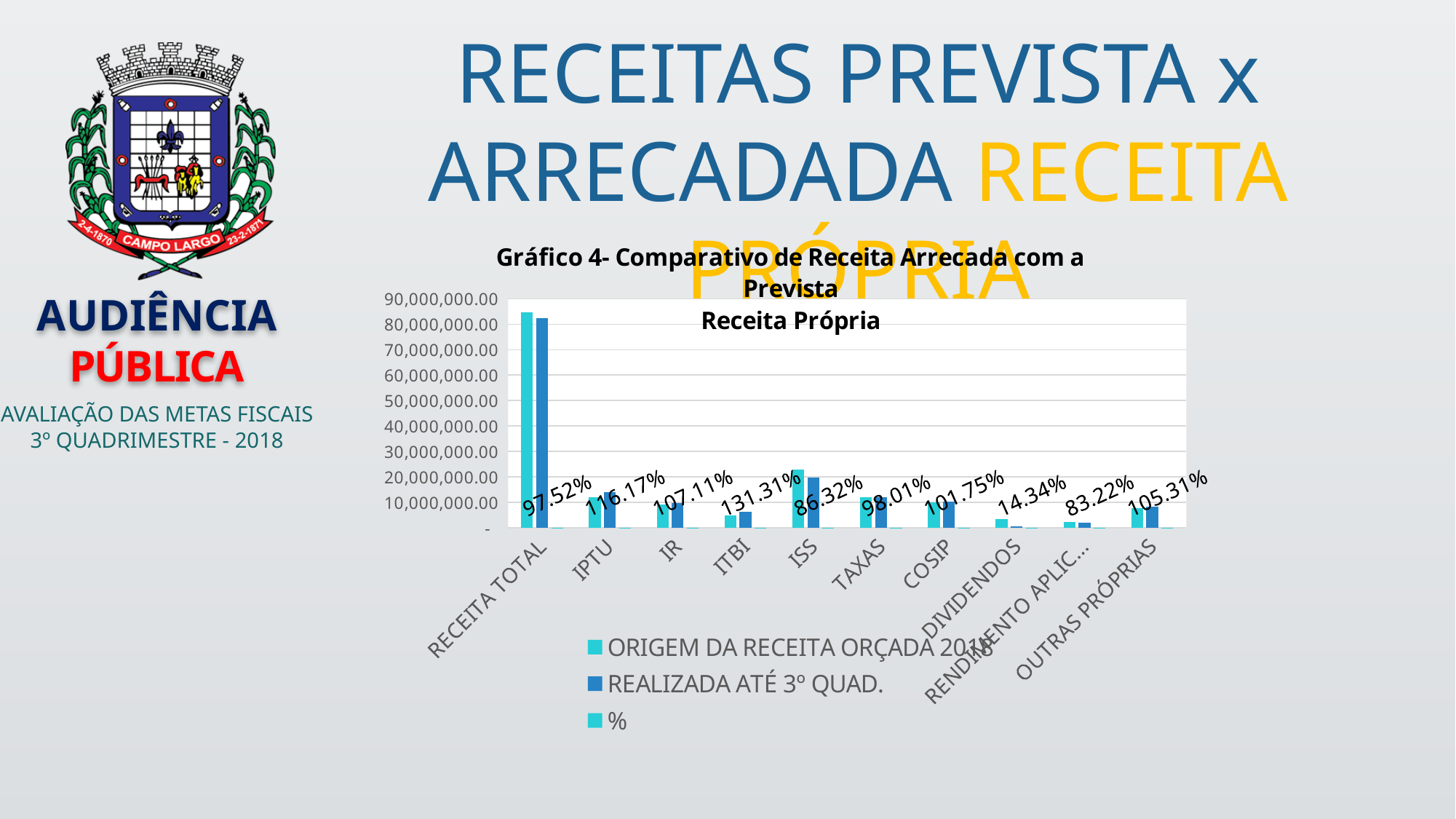
Which has a higher percentage label, IPTU or IR? IPTU How many categories are shown on the x axis of the chart? 10 What is the percentage label shown for RECEITA TOTAL? 97.52% What is the percentage label shown for DIVIDENDOS? 14.34% What type of chart is shown on the slide? bar chart Which category has the highest percentage label? ITBI How many series does the chart legend list? 3 What is the title of the chart? Gráfico 4- Comparativo de Receita Arrecada com a Prevista Receita Própria What is the percentage label shown for ITBI? 131.31% What is the difference between the percentage labels for IPTU and RECEITA TOTAL? 18.65% Which category has the lowest percentage label? DIVIDENDOS Is the ORIGEM DA RECEITA ORÇADA 2018 value for RECEITA TOTAL greater or less than 80,000,000.00? greater